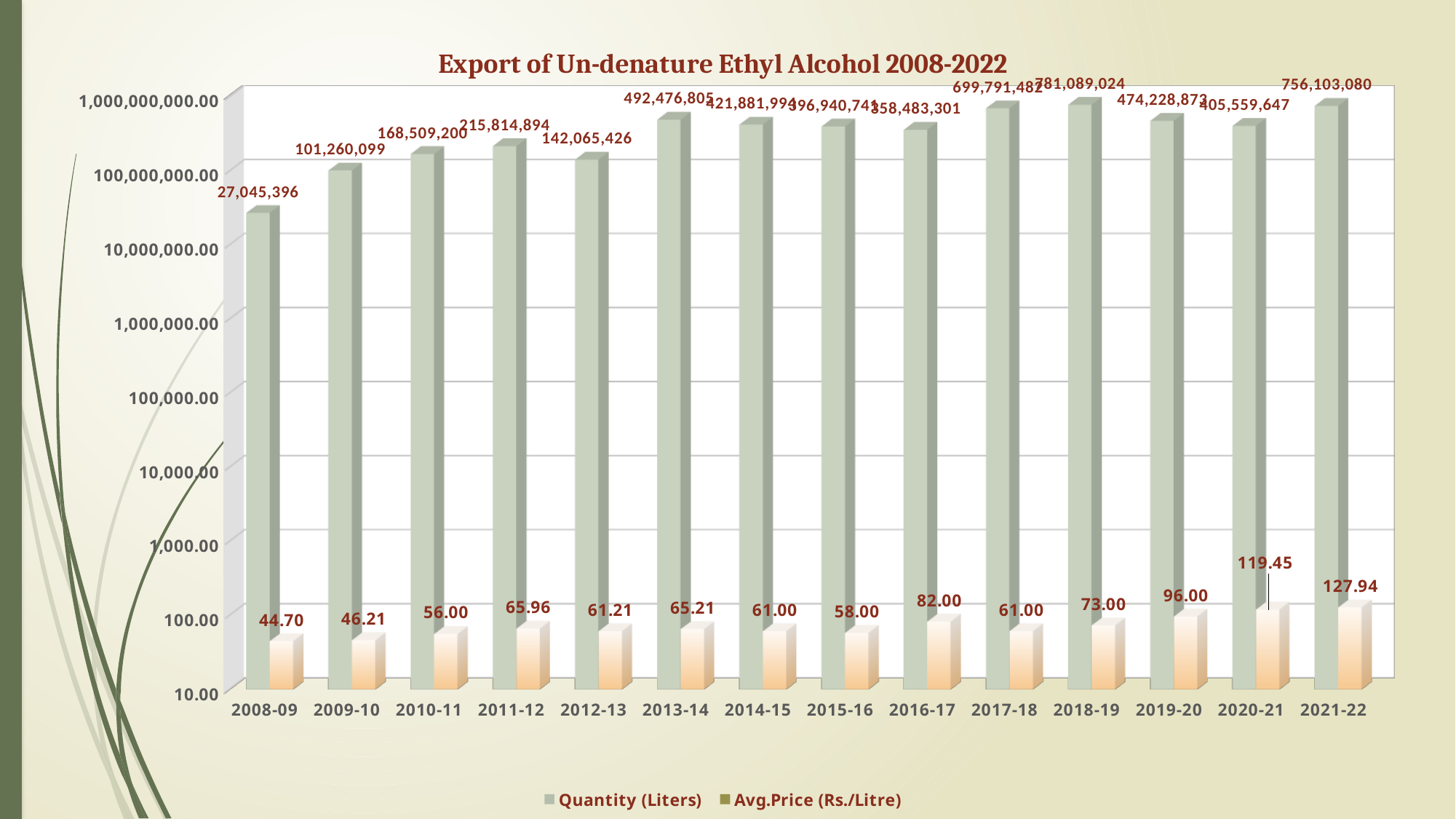
Is the Quantity (Liters) value for 2008-09 greater or less than 100,000,000.00? less What is the title of the chart? Export of Un-denature Ethyl Alcohol 2008-2022 How many series does the legend list? 2 Which year has the highest Avg.Price (Rs./Litre)? 2021-22 What is the difference between the Avg.Price (Rs./Litre) for 2021-22 and 2020-21? 8.49 What kind of chart is shown on the slide? bar chart What is the Avg.Price (Rs./Litre) for 2016-17? 82.00 Which is larger, the Quantity (Liters) for 2013-14 or for 2012-13? 2013-14 Which year has the lowest Quantity (Liters)? 2008-09 How many years are shown on the x axis? 14 What is the Quantity (Liters) value for 2021-22? 756,103,080 What is the Quantity (Liters) value for 2008-09? 27,045,396